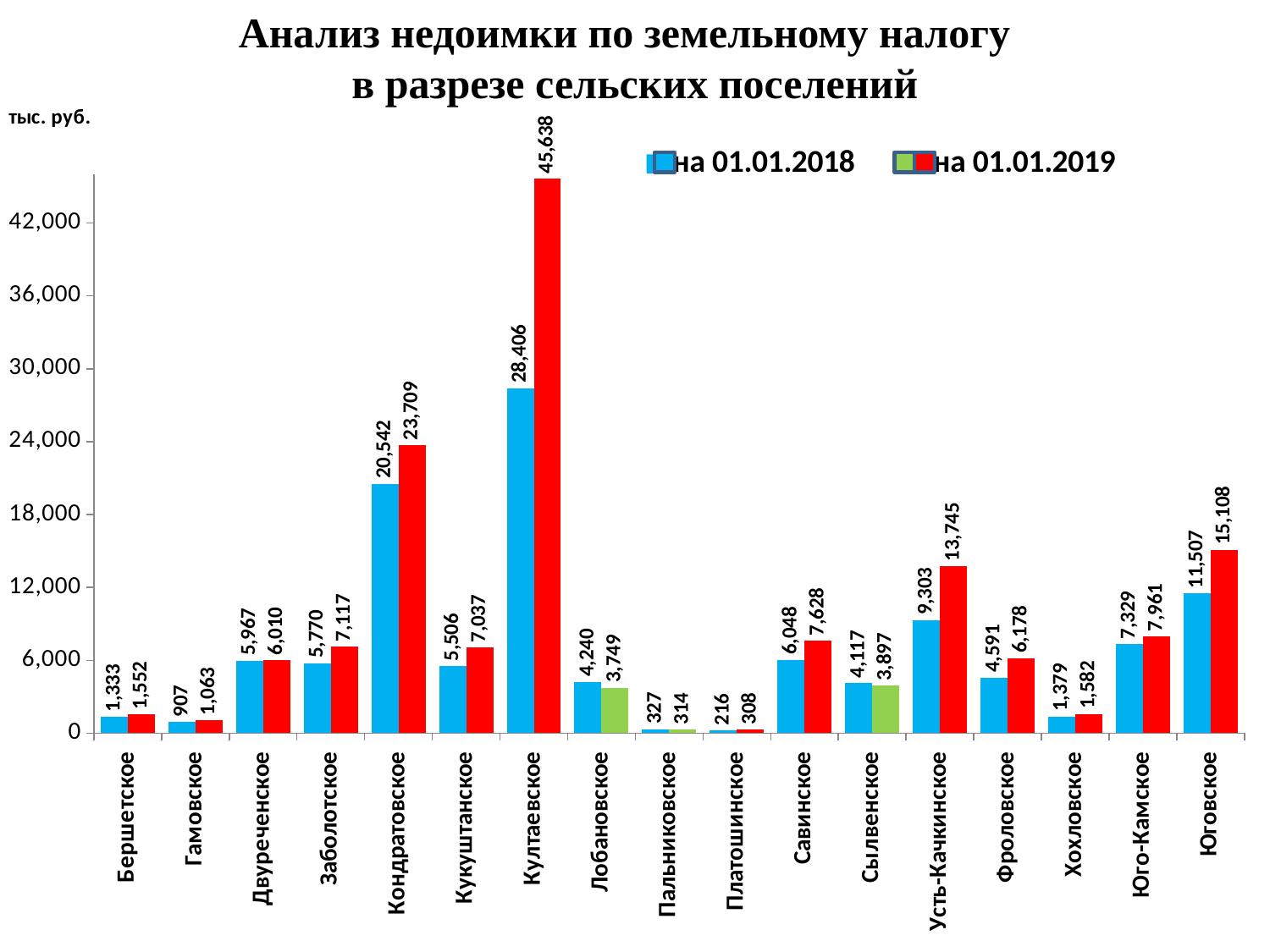
Which settlement has the lowest value on 01.01.2018? Платошинское What kind of chart is shown on the slide? bar chart How many settlements are shown on the x axis? 17 What unit is indicated in the top-left corner of the chart? тыс. руб. Which settlement has the highest value on 01.01.2019? Култаевское Which is larger for Лобановское: the value on 01.01.2018 or on 01.01.2019? на 01.01.2018 Is the value for Юговское on 01.01.2019 greater or less than 12,000? greater What is the value for Кондратовское on 01.01.2018? 20,542 What is the difference between the 01.01.2019 and 01.01.2018 values for Култаевское? 17,232 What is the value for Култаевское on 01.01.2019? 45,638 How many series does the legend list? 2 What is the value for Усть-Качкинское on 01.01.2019? 13,745